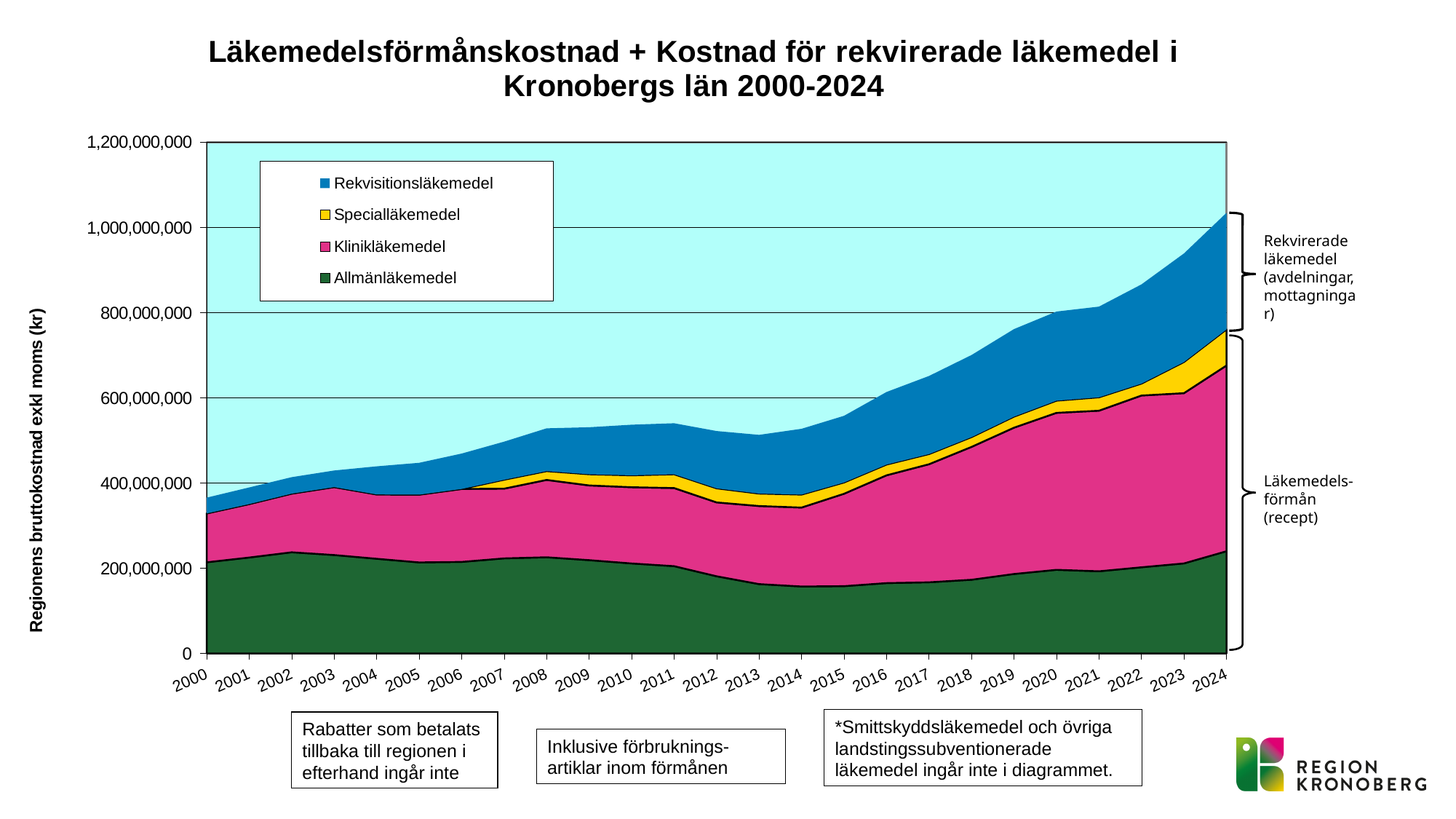
How many series does the legend list? 4 How many years are plotted along the x axis? 25 Is the value for Allmänläkemedel in 2024 greater or less than 200,000,000? greater Which series is listed first in the legend? Rekvisitionsläkemedel Which year has the lowest total cost? 2000 Does the total cost generally rise or fall from 2000 to 2024? rise Which year has the highest total cost? 2024 Is the value for Allmänläkemedel in 2014 greater or less than 200,000,000? less What kind of chart is shown on the slide? Stacked area chart Is the total cost in 2000 greater or less than 400,000,000? less What is the title of the y axis? Regionens bruttokostnad exkl moms (kr)